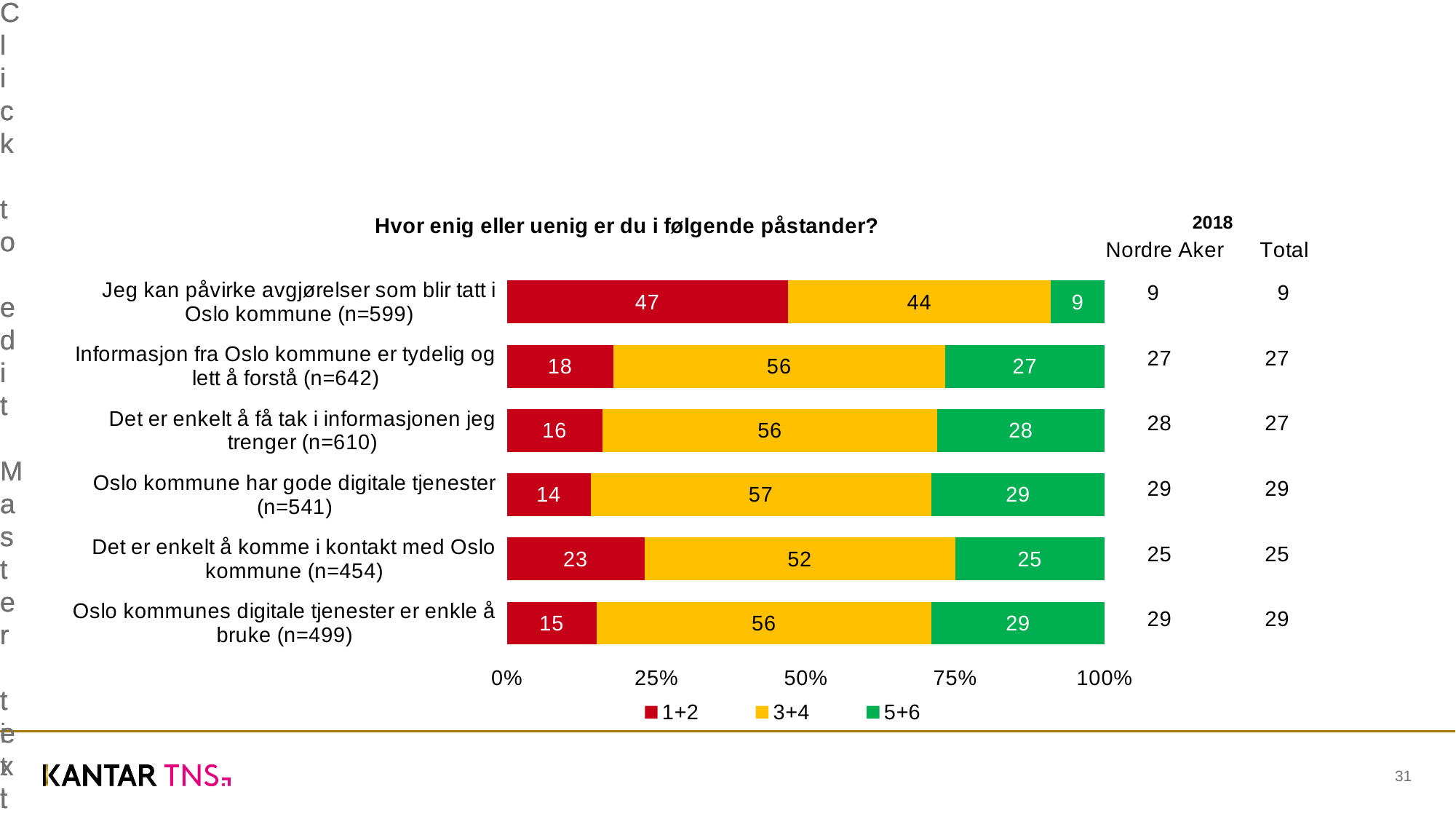
How many statements (categories) are plotted in the chart? 6 Which statement has the highest 1+2 value? Jeg kan påvirke avgjørelser som blir tatt i Oslo kommune Which statement has the lowest 1+2 value? Oslo kommune har gode digitale tjenester What is the value of the 5+6 segment for "Det er enkelt å komme i kontakt med Oslo kommune"? 25 What is the difference between the 1+2 values for "Det er enkelt å komme i kontakt med Oslo kommune" and "Oslo kommunes digitale tjenester er enkle å bruke"? 8 Which statement has the lowest 5+6 value? Jeg kan påvirke avgjørelser som blir tatt i Oslo kommune How many series does the legend list? 3 What is the title of the chart? Hvor enig eller uenig er du i følgende påstander? What is the value of the 3+4 segment for "Oslo kommune har gode digitale tjenester"? 57 Which is larger: the 5+6 value for "Informasjon fra Oslo kommune er tydelig og lett å forstå" or for "Oslo kommune har gode digitale tjenester"? Oslo kommune har gode digitale tjenester What is the value of the 1+2 segment for "Jeg kan påvirke avgjørelser som blir tatt i Oslo kommune"? 47 What kind of chart is shown on the slide? Stacked bar chart